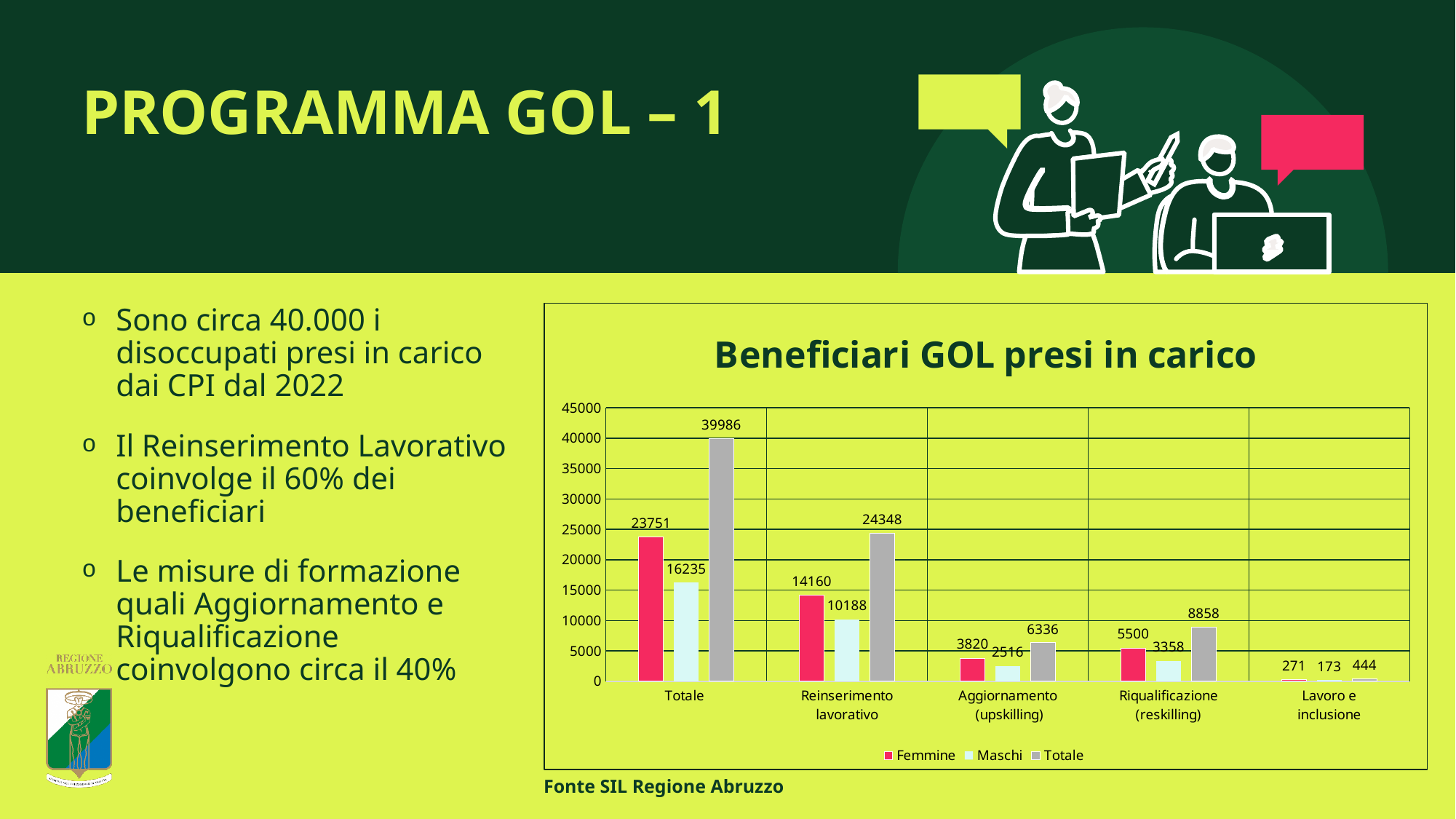
What is the Totale value for Riqualificazione (reskilling)? 8858 How many categories are shown on the x axis? 5 What is the value for Femmine in the Totale category? 23751 Excluding the Totale category, which category has the highest Totale value? Reinserimento lavorativo What is the value for Maschi in the Reinserimento lavorativo category? 10188 What kind of chart is shown on the slide? Bar chart How many series does the legend list? 3 Which category has the lowest Femmine value? Lavoro e inclusione What is the value for Maschi in the Lavoro e inclusione category? 173 What is the title of the chart? Beneficiari GOL presi in carico What is the difference between the Femmine and Maschi values in the Totale category? 7516 Which is larger in the Aggiornamento (upskilling) category: Femmine or Maschi? Femmine